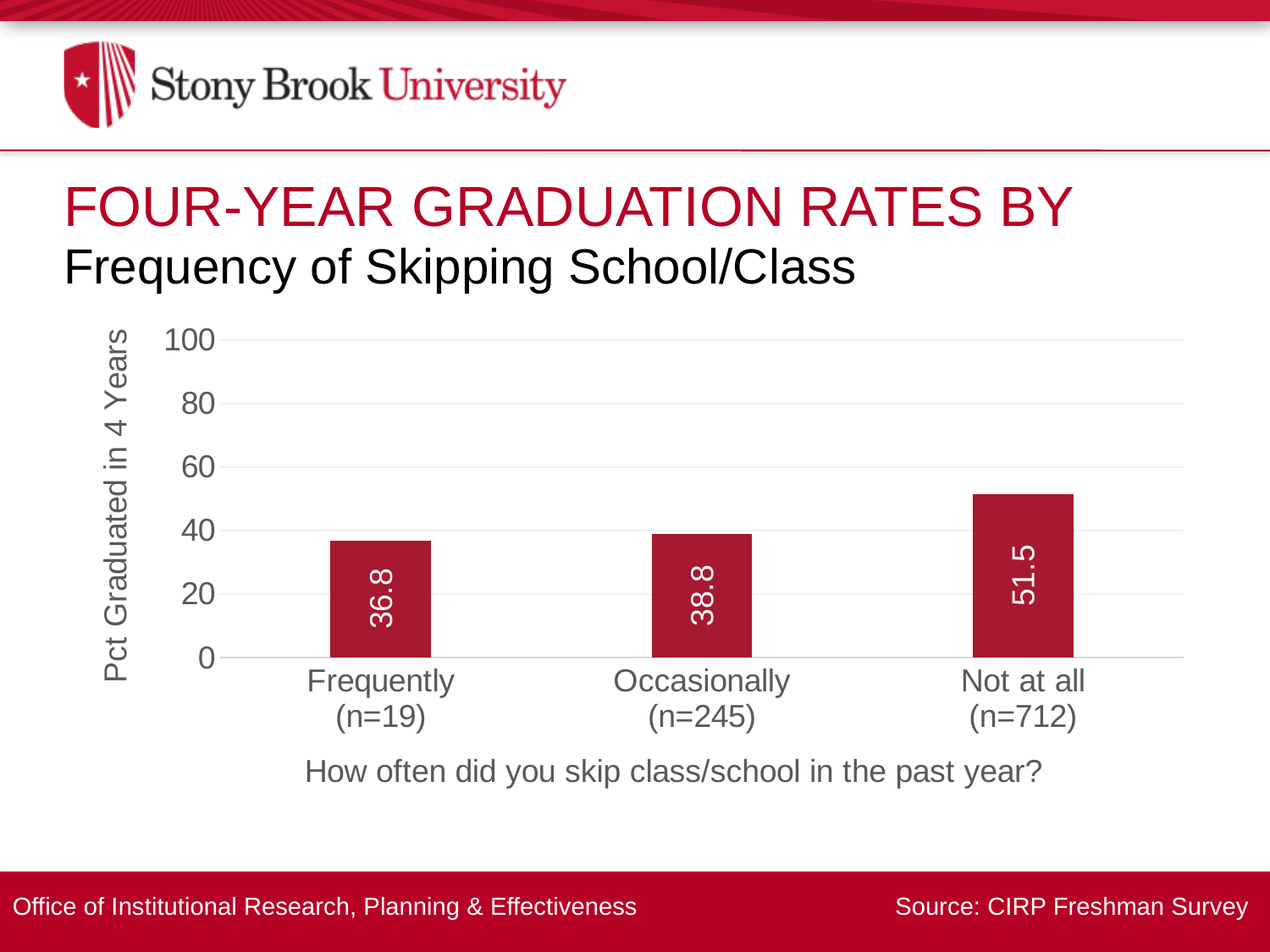
What is the four-year graduation rate for students who did Not at all skip class? 51.5 How many categories are shown on the x axis? 3 Which category has the highest four-year graduation rate? Not at all What kind of chart is shown on the slide? Bar chart What is the label of the y axis? Pct Graduated in 4 Years What is the four-year graduation rate for students who skipped class Frequently? 36.8 Is the value for Not at all greater or less than 40? greater What is the difference in graduation rate between Occasionally and Frequently? 2.0 What is the difference in graduation rate between Not at all and Frequently? 14.7 Which category has the lowest four-year graduation rate? Frequently What is the four-year graduation rate for students who skipped class Occasionally? 38.8 Which has a higher graduation rate, Not at all or Occasionally? Not at all